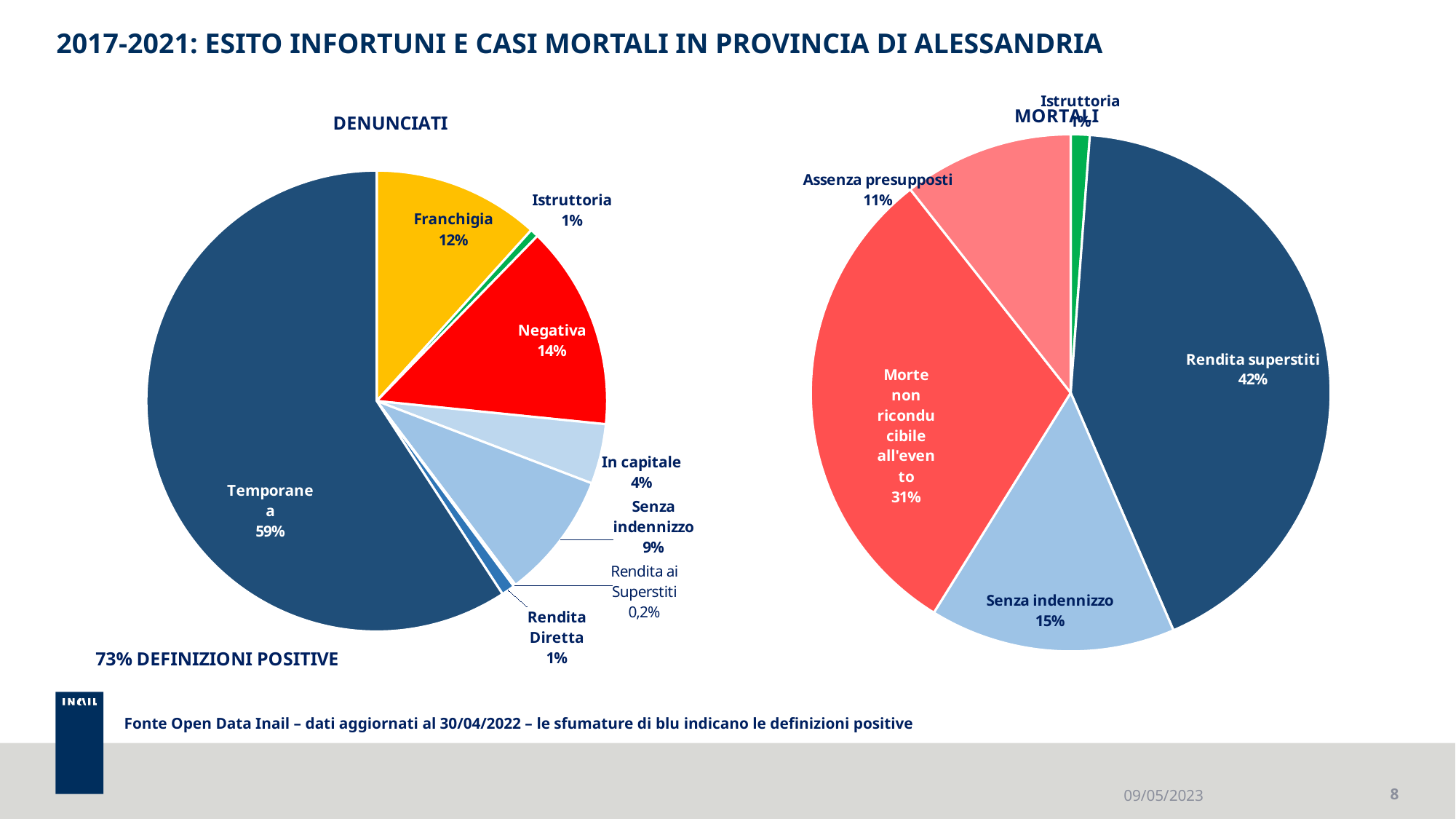
In the MORTALI chart, which category has the largest share? Rendita superstiti How many slices does the MORTALI chart have? 5 In the MORTALI chart, what is the share for Rendita superstiti? 42% In the MORTALI chart, which is larger: Senza indennizzo or Assenza presupposti? Senza indennizzo In the DENUNCIATI chart, which category has the smallest share? Rendita ai Superstiti In the DENUNCIATI chart, what is the share for Negativa? 14% In the DENUNCIATI chart, what is the share for Temporanea? 59% What type of chart is the DENUNCIATI chart? pie chart In the DENUNCIATI chart, what is the share for Rendita ai Superstiti? 0,2% In the DENUNCIATI chart, which category has the largest share? Temporanea In the DENUNCIATI chart, what is the difference between the shares of Franchigia and Senza indennizzo? 3% How many slices does the DENUNCIATI chart have? 8